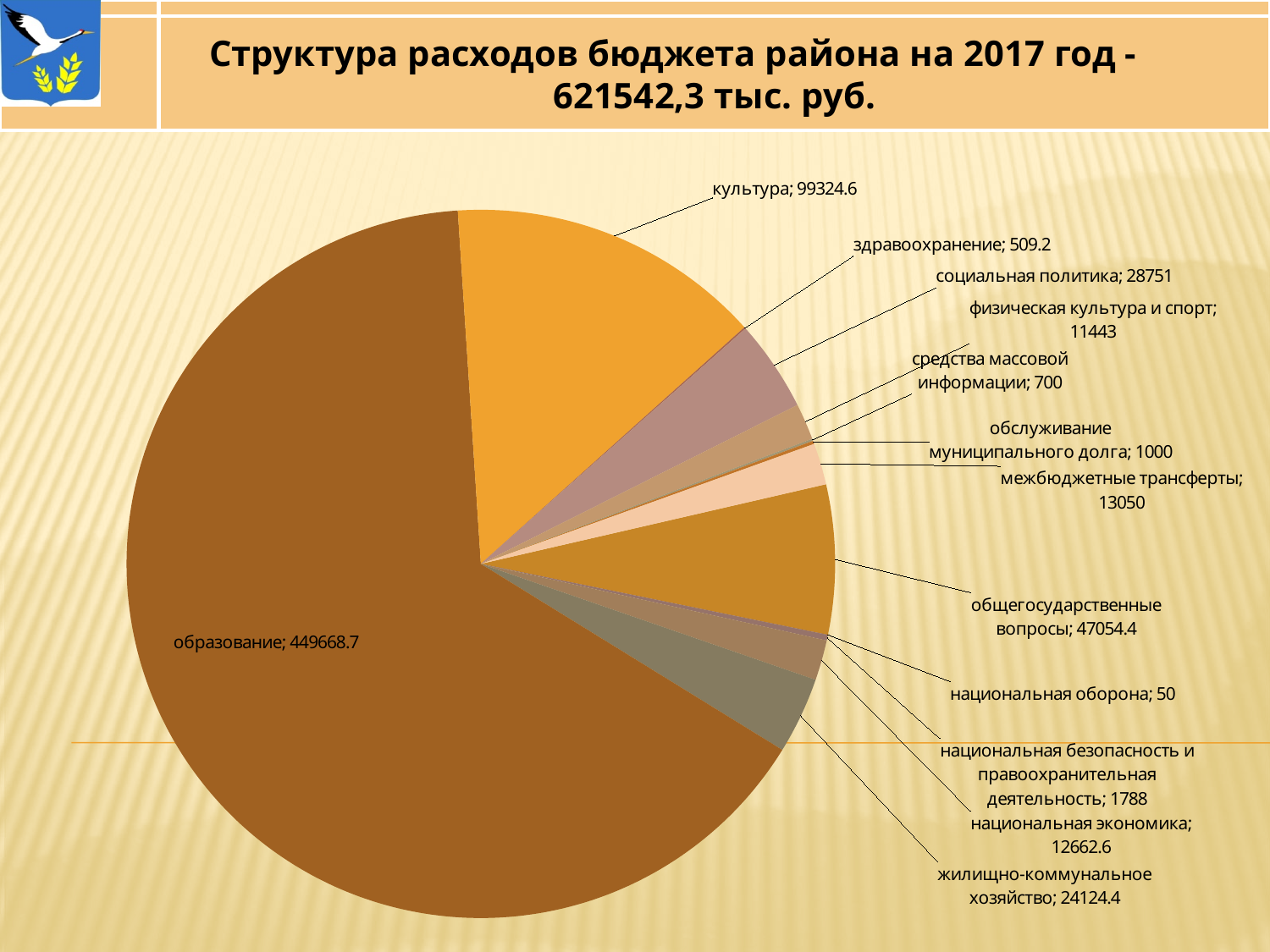
What is the difference between the values for общегосударственные вопросы and социальная политика? 18303.4 What is the value for культура? 99324.6 What total budget expenditure amount is stated in the slide title? 621542,3 тыс. руб. Which is larger: социальная политика or жилищно-коммунальное хозяйство? социальная политика Which category has the largest slice of the pie? образование Which category has the smallest value? национальная оборона How many categories (slices) does the pie chart have? 13 What kind of chart is shown on the slide? pie chart What is the difference between the values for образование and культура? 350344.1 What is the value for общегосударственные вопросы? 47054.4 What is the value for образование? 449668.7 What is the value for жилищно-коммунальное хозяйство? 24124.4